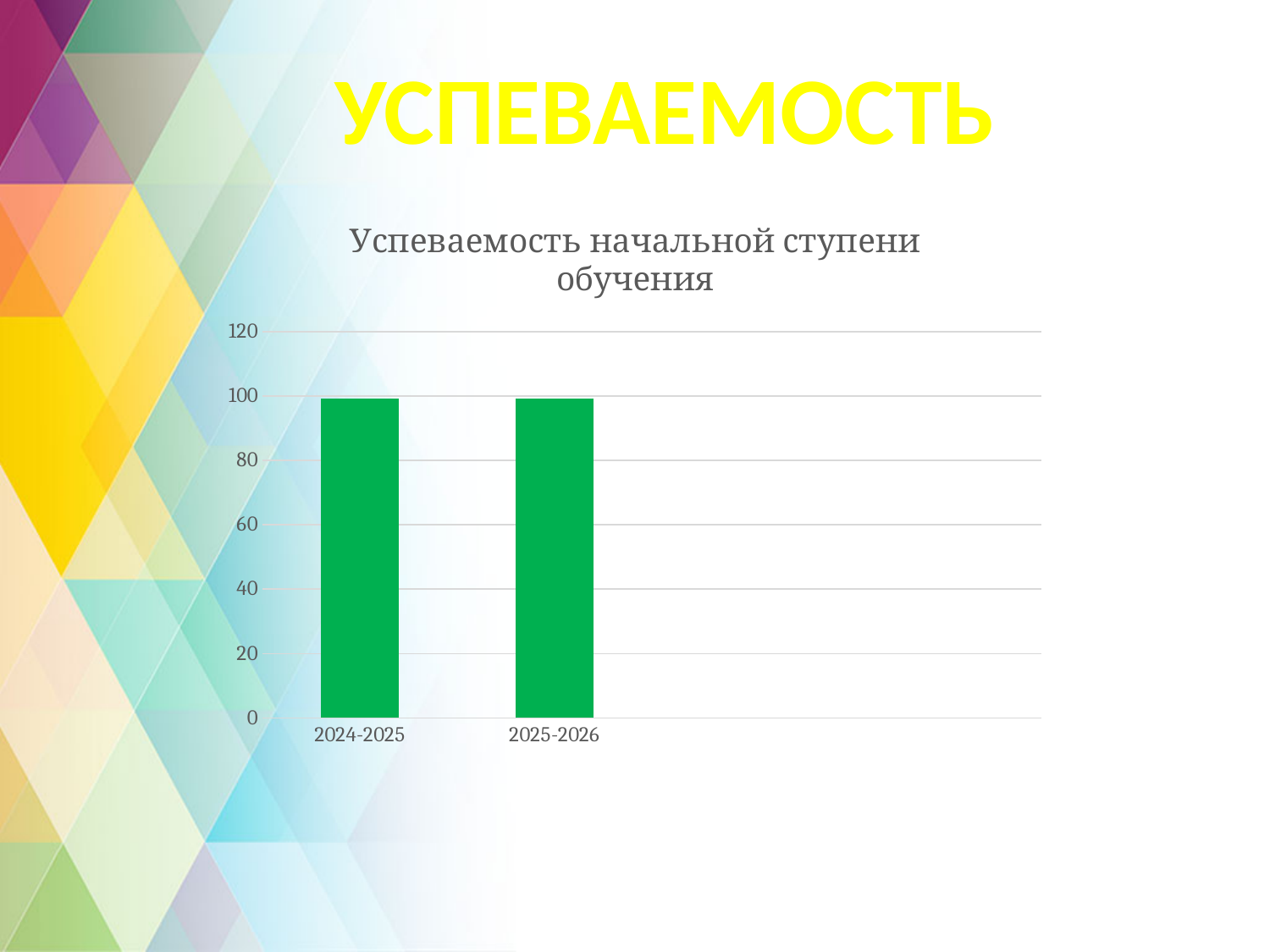
Is the value for 2025-2026 greater or less than 60? greater Is the value for 2024-2025 greater or less than 120? less Is the value for 2025-2026 greater or less than 80? greater Which two school years are shown as categories on the x axis? 2024-2025 and 2025-2026 What is the title of the chart? Успеваемость начальной ступени обучения What kind of chart is shown on the slide? bar chart How many categories are shown on the x axis of the chart? 2 What is the highest value shown on the y axis of the chart? 120